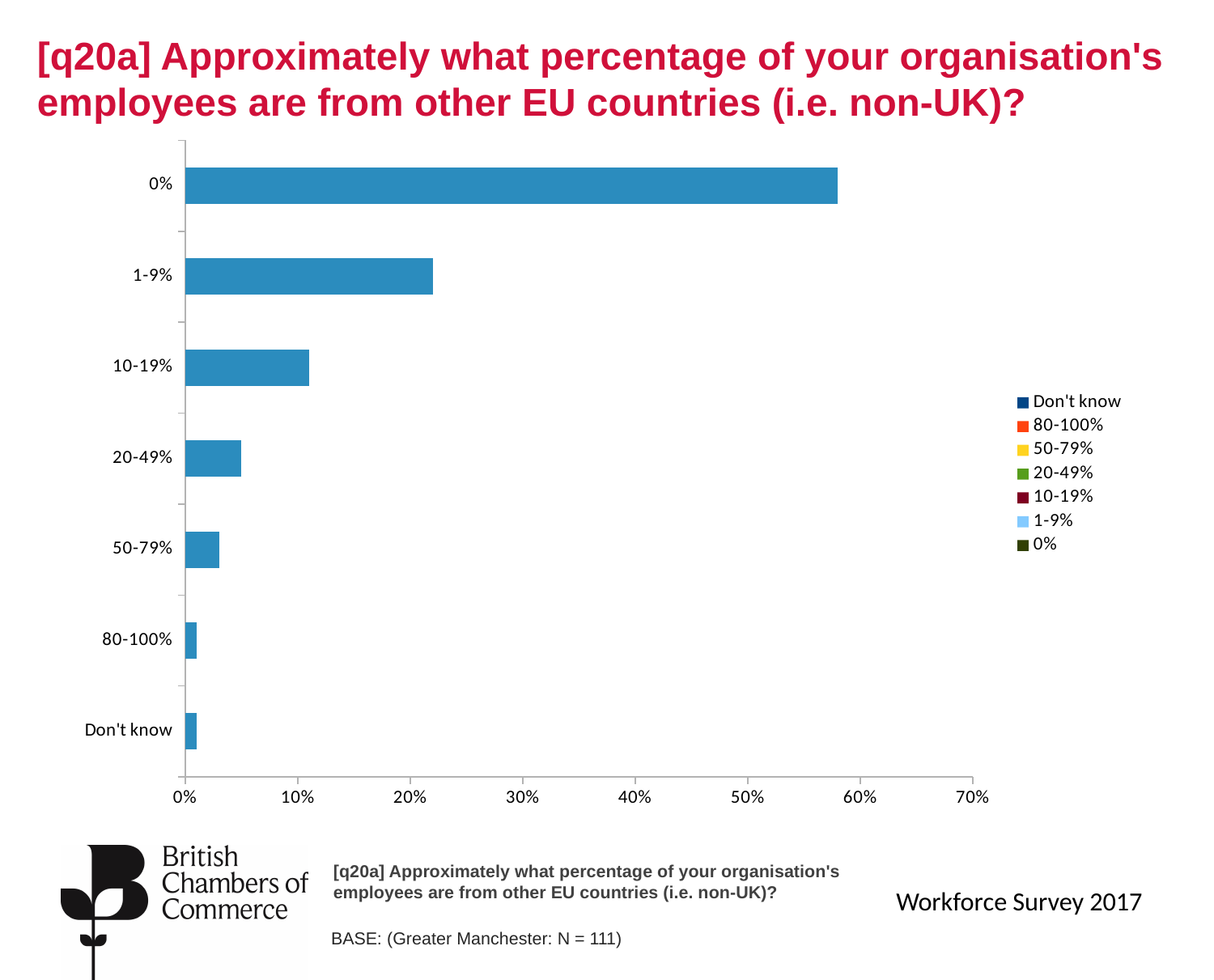
Which is larger, the value for 20-49% or the value for 50-79%? 20-49% What kind of chart is shown on the slide? bar chart Is the value for the 0% category greater or less than 50%? greater How many entries does the legend list? 7 What is the highest value shown on the horizontal axis? 70% Is the value for the 0% category greater or less than 60%? less Which category has the highest value? 0% Is the value for the 20-49% category greater or less than 10%? less Which is larger, the value for 1-9% or the value for 10-19%? 1-9% How many categories are plotted on the chart? 7